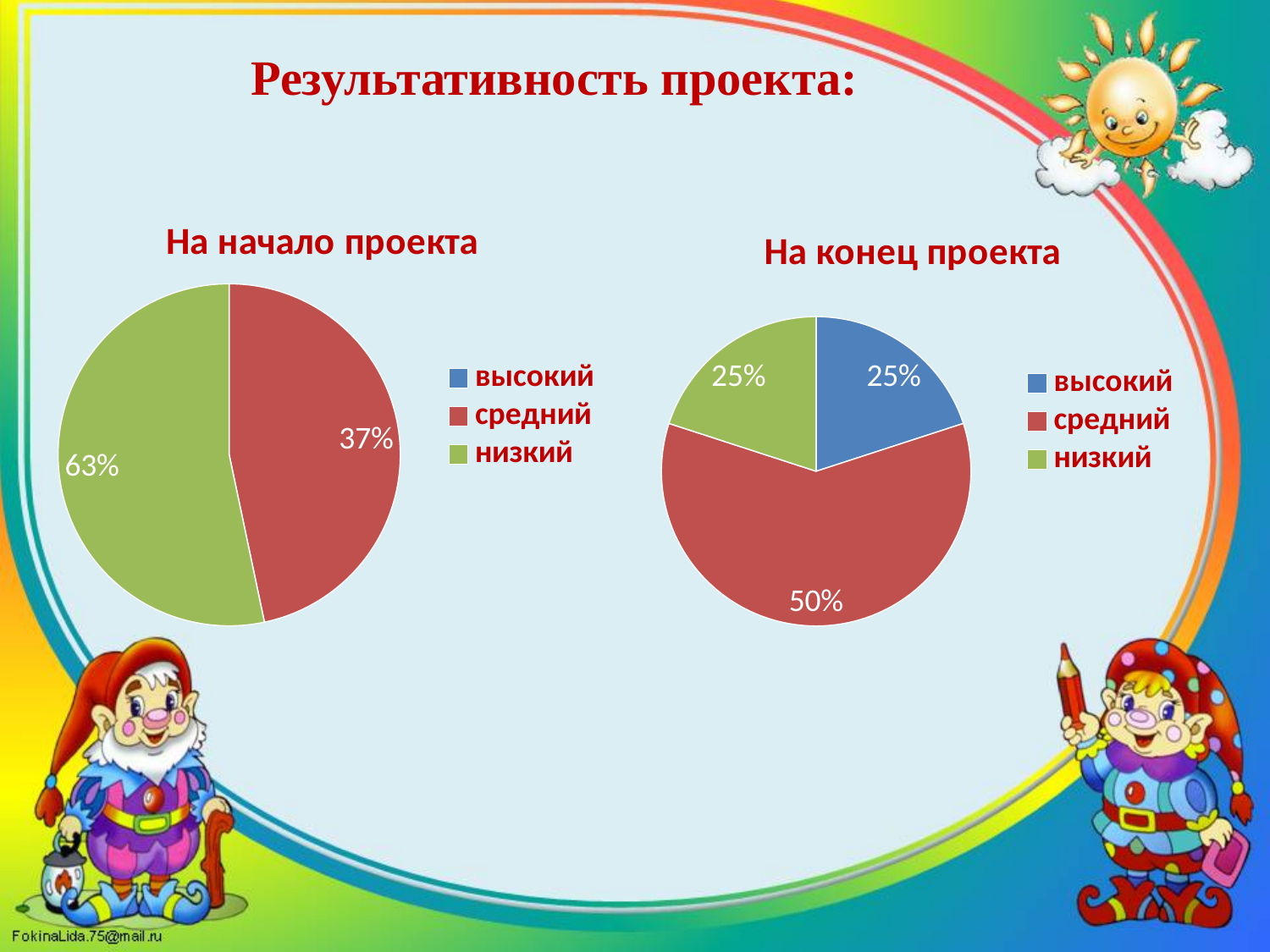
What type of chart is used on the left side of the slide, titled "На начало проекта"? pie chart In the chart titled "На конец проекта", what colour is the "высокий" slice? blue In the chart titled "На начало проекта", what share does the "низкий" slice have? 63% In the chart titled "На начало проекта", what share does the "средний" slice have? 37% In the chart titled "На конец проекта", which is larger: the "средний" slice or the "высокий" slice? средний In the chart titled "На конец проекта", which category has the largest slice? средний In the chart titled "На начало проекта", which category has the largest slice? низкий In the chart titled "На конец проекта", what is the difference between the "средний" and "низкий" shares? 25% In the chart titled "На конец проекта", what share does the "высокий" slice have? 25% In the chart titled "На конец проекта", what share does the "средний" slice have? 50% How many entries does the legend of the chart titled "На конец проекта" list? 3 In the chart titled "На начало проекта", what is the difference between the "низкий" and "средний" shares? 26%